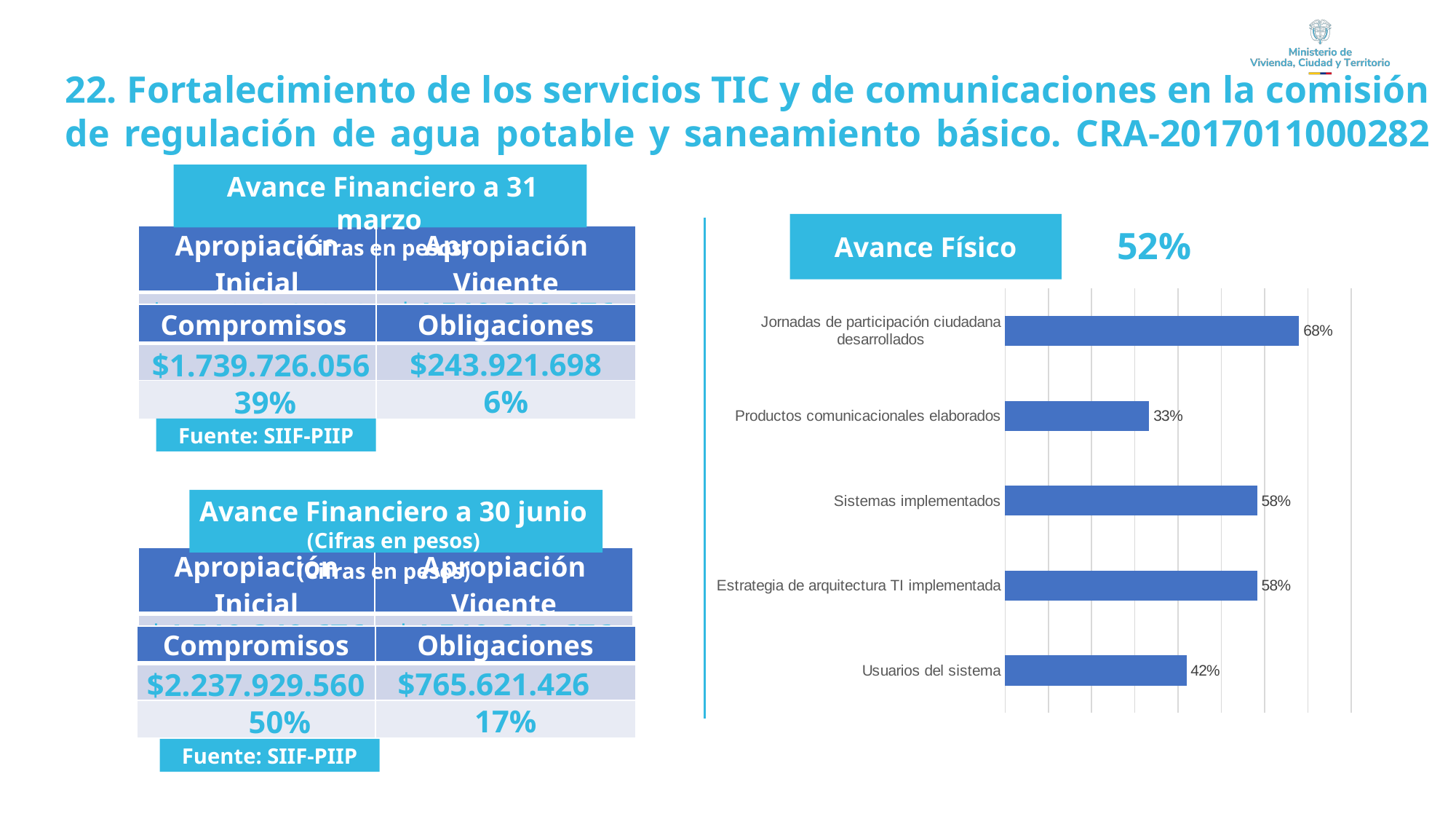
What overall percentage is shown next to the Avance Físico heading above the chart? 52% Which category has the highest value? Jornadas de participación ciudadana desarrollados What is the difference between the values for Estrategia de arquitectura TI implementada and Productos comunicacionales elaborados? 25% What value is shown for Jornadas de participación ciudadana desarrollados? 68% What value is shown for Productos comunicacionales elaborados? 33% What value is shown for Usuarios del sistema? 42% Which category has the lowest value? Productos comunicacionales elaborados How many categories are shown in the bar chart? 5 What kind of chart is shown on the slide? Bar chart What is the difference between the values for Jornadas de participación ciudadana desarrollados and Usuarios del sistema? 26% Which is larger, the value for Usuarios del sistema or the value for Productos comunicacionales elaborados? Usuarios del sistema What value is shown for Sistemas implementados? 58%